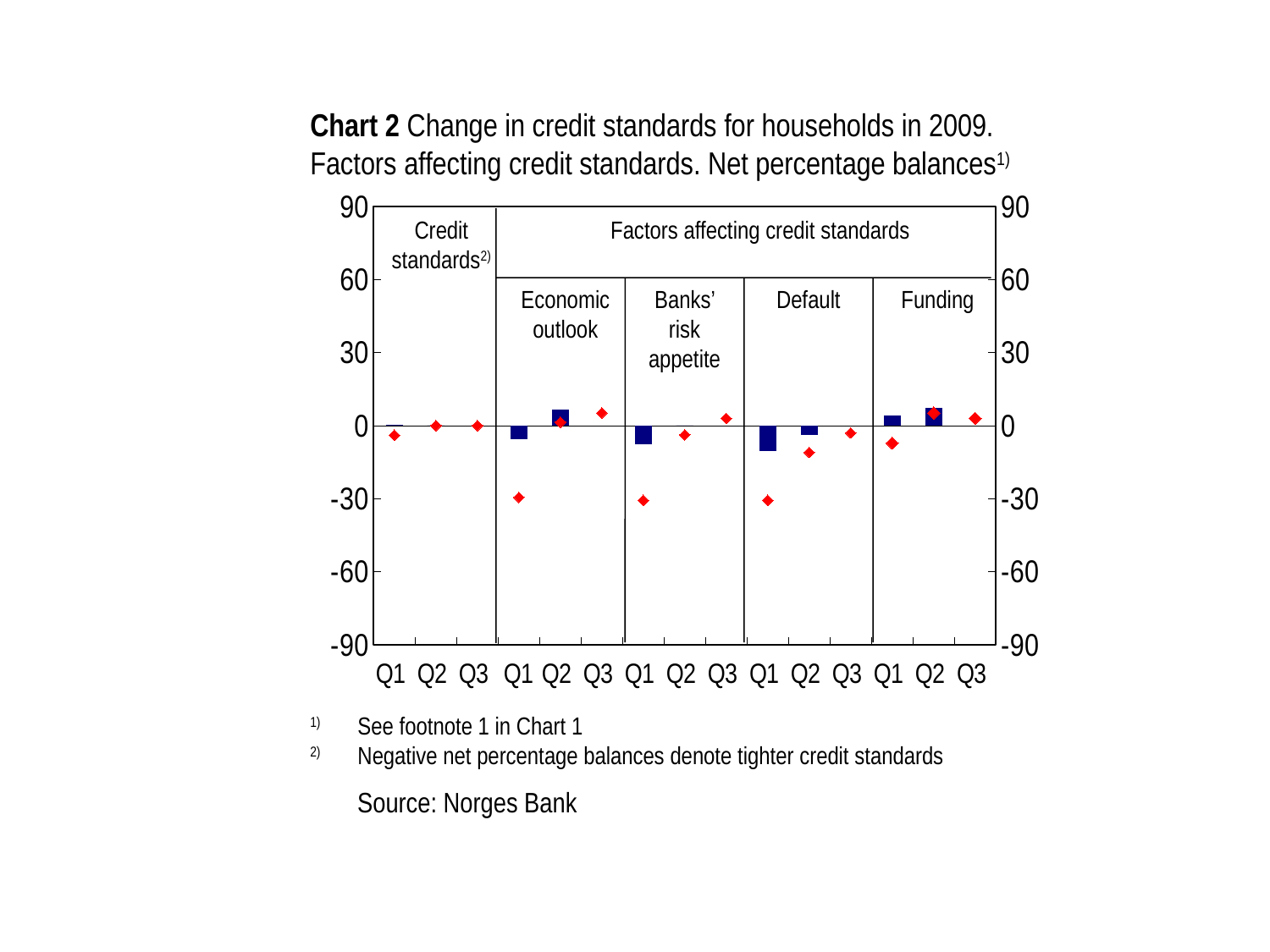
What source is cited for the chart? Norges Bank Is the bar for Q1 under Default greater or less than 0? less What kind of chart is shown on the slide? combination bar and line chart (bars with diamond markers) Is the red diamond for Q1 under Default greater or less than 0? less Is the bar for Q2 under Funding greater or less than 0? greater How many factors affecting credit standards are shown as separate panels in the chart? 4 What is the highest value shown on the vertical axis? 90 How many quarters are shown on the x axis in total across all panels? 15 Under Default, which bar is lower, Q1 or Q2? Q1 Under Economic outlook, which red diamond is higher, Q1 or Q3? Q3